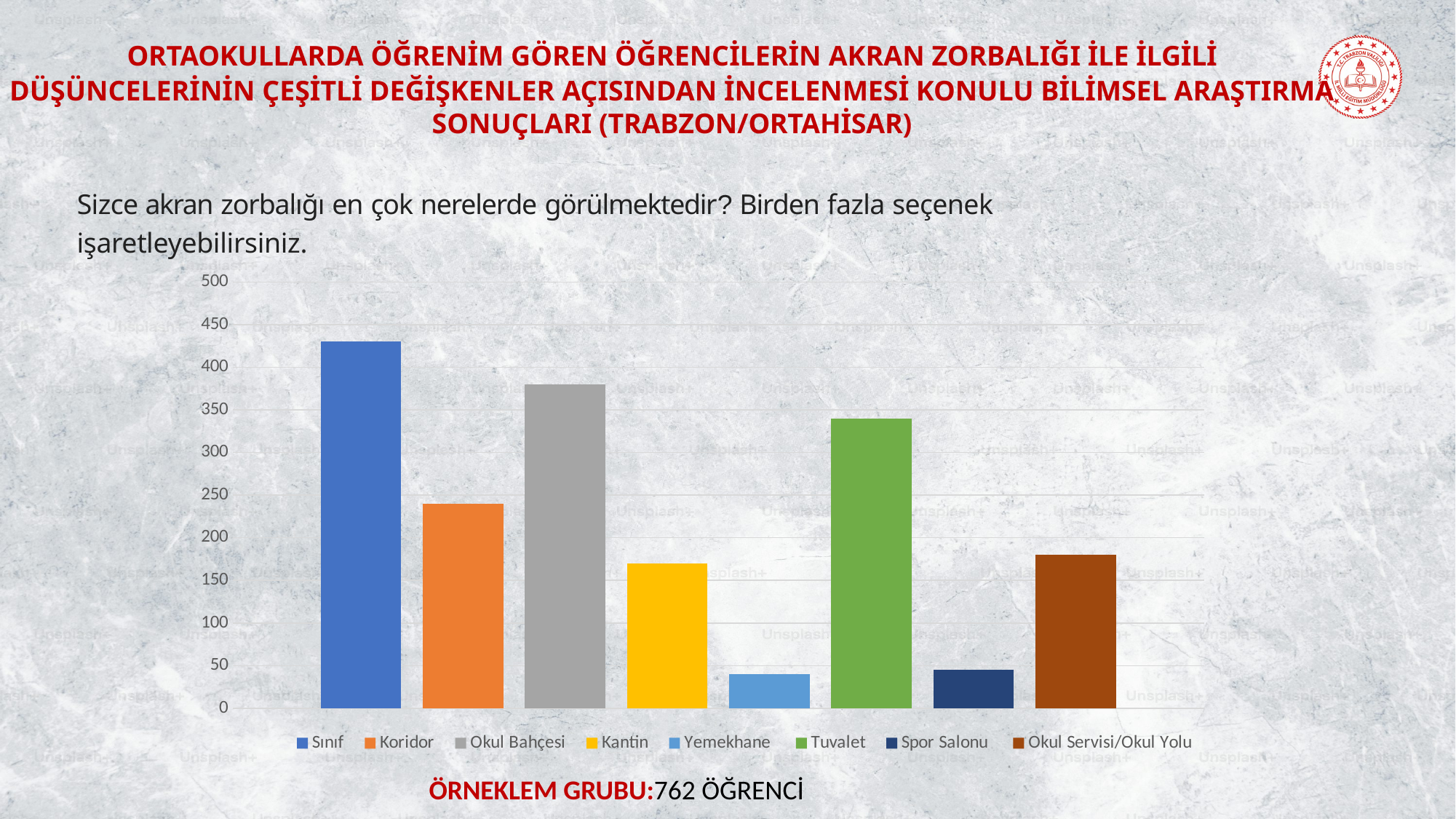
Which is larger, the value for Okul Bahçesi or the value for Tuvalet? Okul Bahçesi What colour is the bar for Tuvalet in the chart? green Which category has the highest value in the chart? Sınıf Is the value for Okul Bahçesi greater or less than 350? greater How many entries does the chart legend list? 8 Is the value for Yemekhane greater or less than 50? less Is the value for Tuvalet greater or less than 300? greater Which is larger, the value for Kantin or the value for Koridor? Koridor What kind of chart is shown on the slide? bar chart How many categories are plotted in the chart? 8